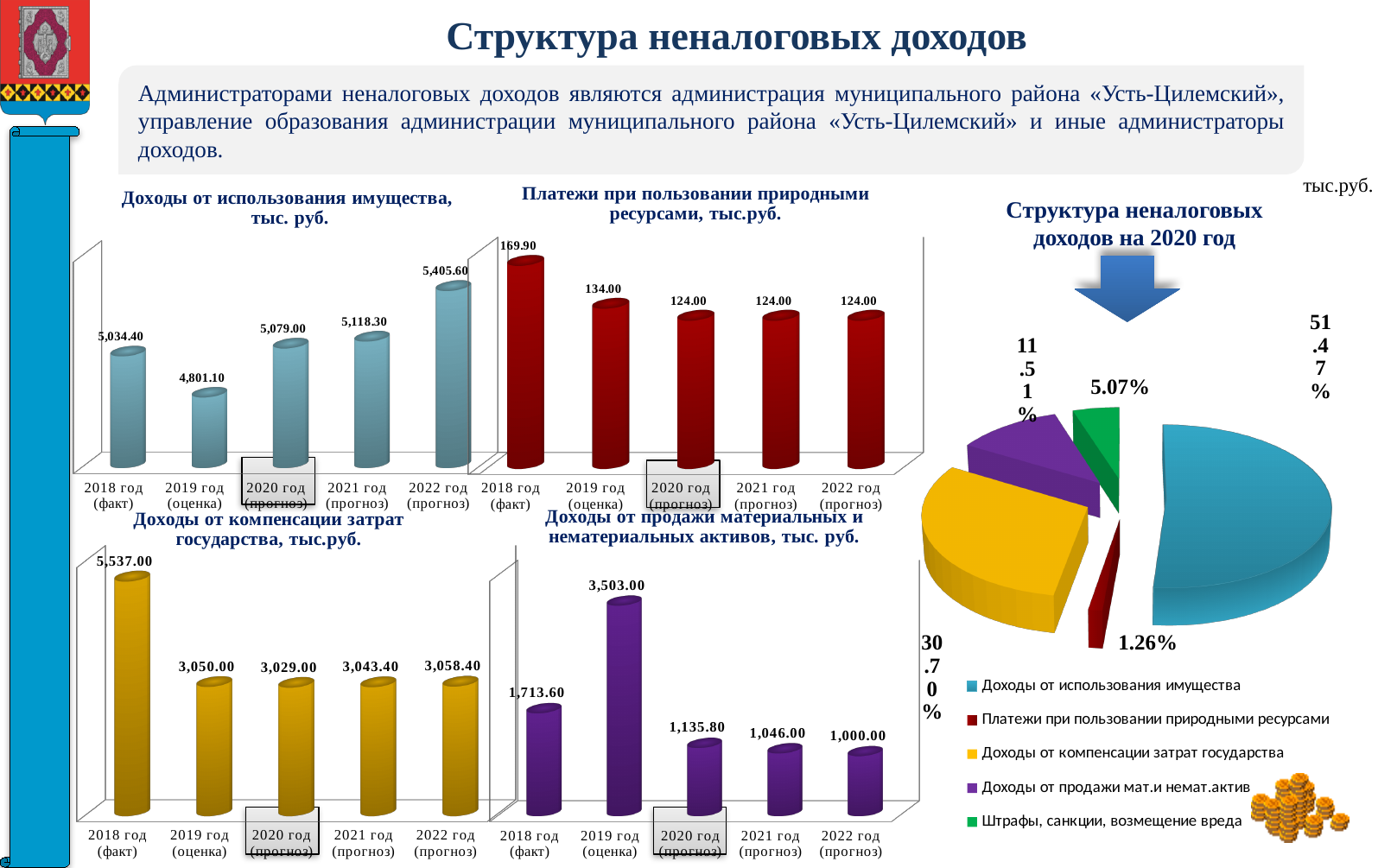
In the chart 'Доходы от продажи материальных и нематериальных активов, тыс. руб.', which is larger: the value for 2018 год (факт) or 2020 год (прогноз)? 2018 год (факт) In the chart 'Доходы от использования имущества, тыс. руб.', what is the value for 2022 год (прогноз)? 5,405.60 In the chart 'Платежи при пользовании природными ресурсами, тыс.руб.', do the values rise or fall from 2018 to 2022? fall What type of chart is 'Структура неналоговых доходов на 2020 год'? pie chart In the chart 'Доходы от продажи материальных и нематериальных активов, тыс. руб.', what is the value for 2019 год (оценка)? 3,503.00 In the chart 'Доходы от компенсации затрат государства, тыс.руб.', what is the value for 2021 год (прогноз)? 3,043.40 How many year categories are shown in the chart 'Доходы от использования имущества, тыс. руб.'? 5 In the chart 'Доходы от использования имущества, тыс. руб.', which year has the lowest value? 2019 год (оценка) In the chart 'Платежи при пользовании природными ресурсами, тыс.руб.', what is the difference between the 2018 год (факт) and 2019 год (оценка) values? 35.90 In the chart 'Доходы от компенсации затрат государства, тыс.руб.', which year has the highest value? 2018 год (факт) In the pie chart 'Структура неналоговых доходов на 2020 год', what share does 'Доходы от использования имущества' have? 51.47% In the chart 'Платежи при пользовании природными ресурсами, тыс.руб.', what is the value for 2018 год (факт)? 169.90